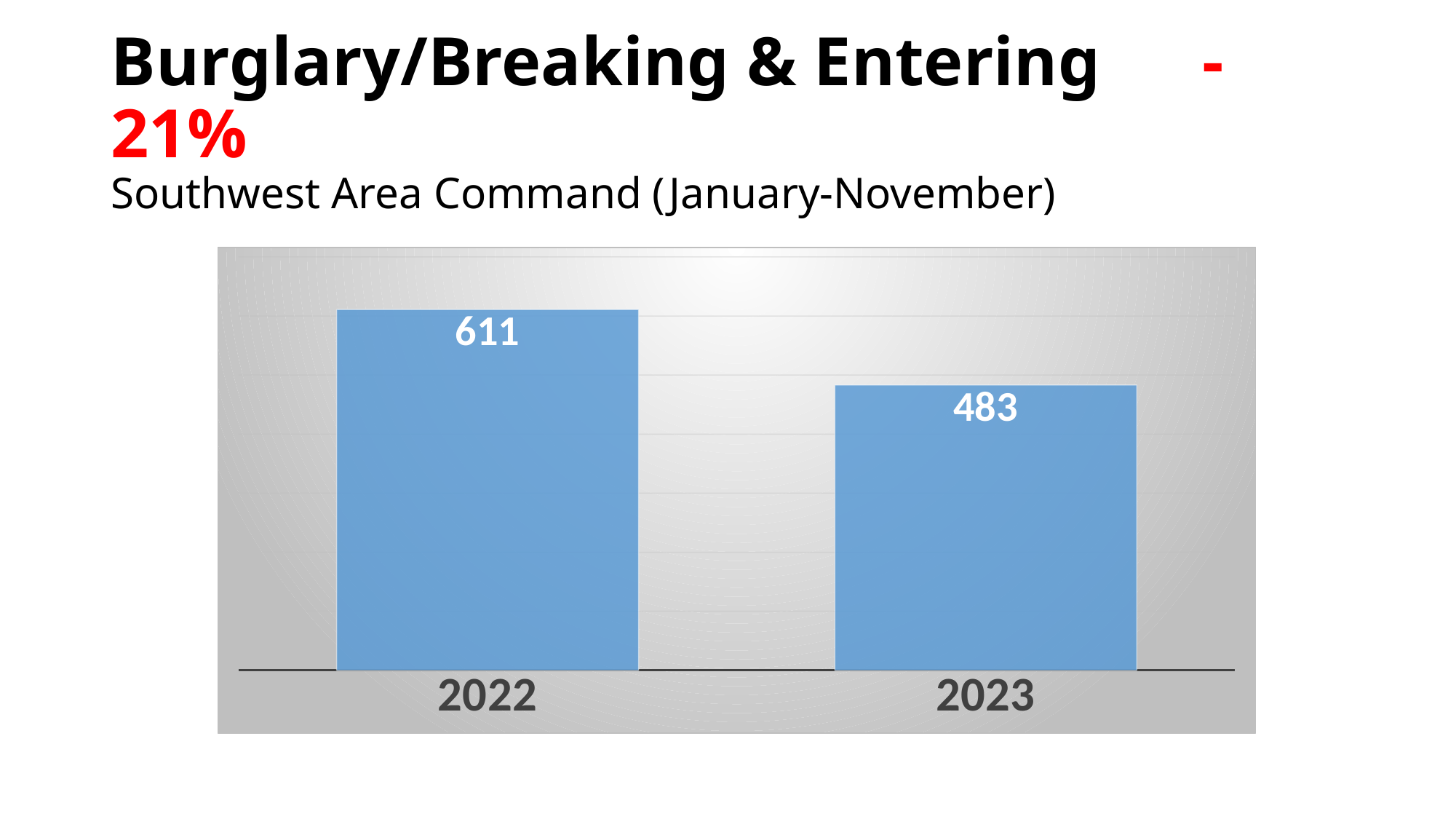
Which is larger, the value for 2022 or the value for 2023? 2022 What is the difference between the 2022 and 2023 values? 128 What percentage change is shown in red in the slide title? -21% What is the value for 2023? 483 Which area command and period does the slide subtitle refer to? Southwest Area Command (January-November) Do the values rise or fall from 2022 to 2023? fall Which year has the lowest value? 2023 What kind of chart is shown on the slide? bar chart What is the value for 2022? 611 How many bars are shown in the chart? 2 Which year has the highest value? 2022